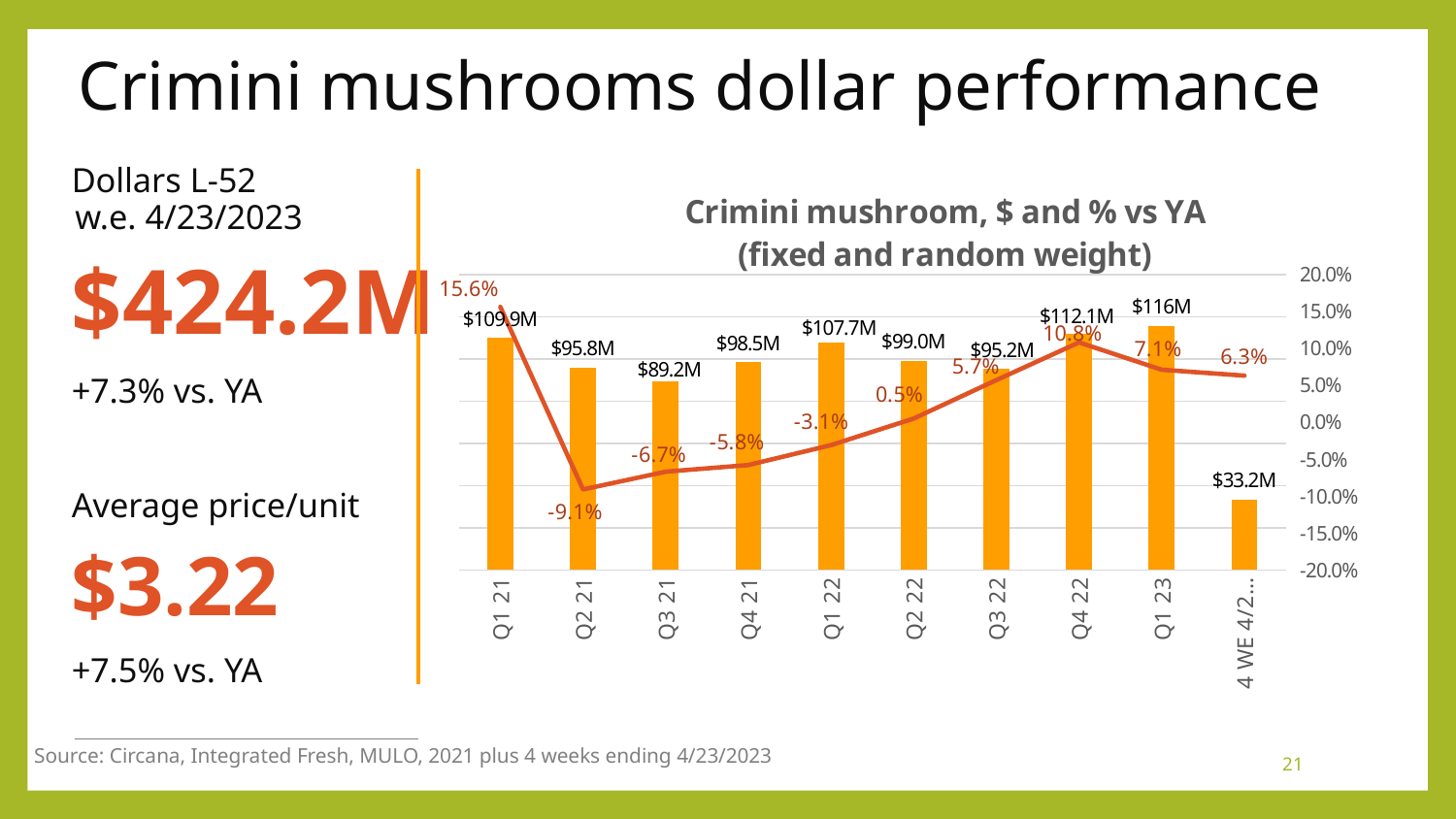
Which quarter has the highest dollar value among the quarterly bars? Q1 23 What is the % vs YA value shown for Q4 22? 10.8% What is the difference in dollar value between Q4 22 and Q3 22? $16.9M What is the title of the chart? Crimini mushroom, $ and % vs YA (fixed and random weight) Is the % vs YA value for Q3 22 greater or less than 5.0%? greater Which period has the lowest % vs YA value on the line? Q2 21 What is the dollar value shown for Q1 23? $116M What is the dollar value shown for Q3 21? $89.2M What is the % vs YA value shown for Q2 21? -9.1% What kind of chart is shown on the slide? Combination bar and line chart How many periods are shown on the x axis of the chart? 10 Which is larger, the dollar value for Q1 21 or for Q1 22? Q1 21